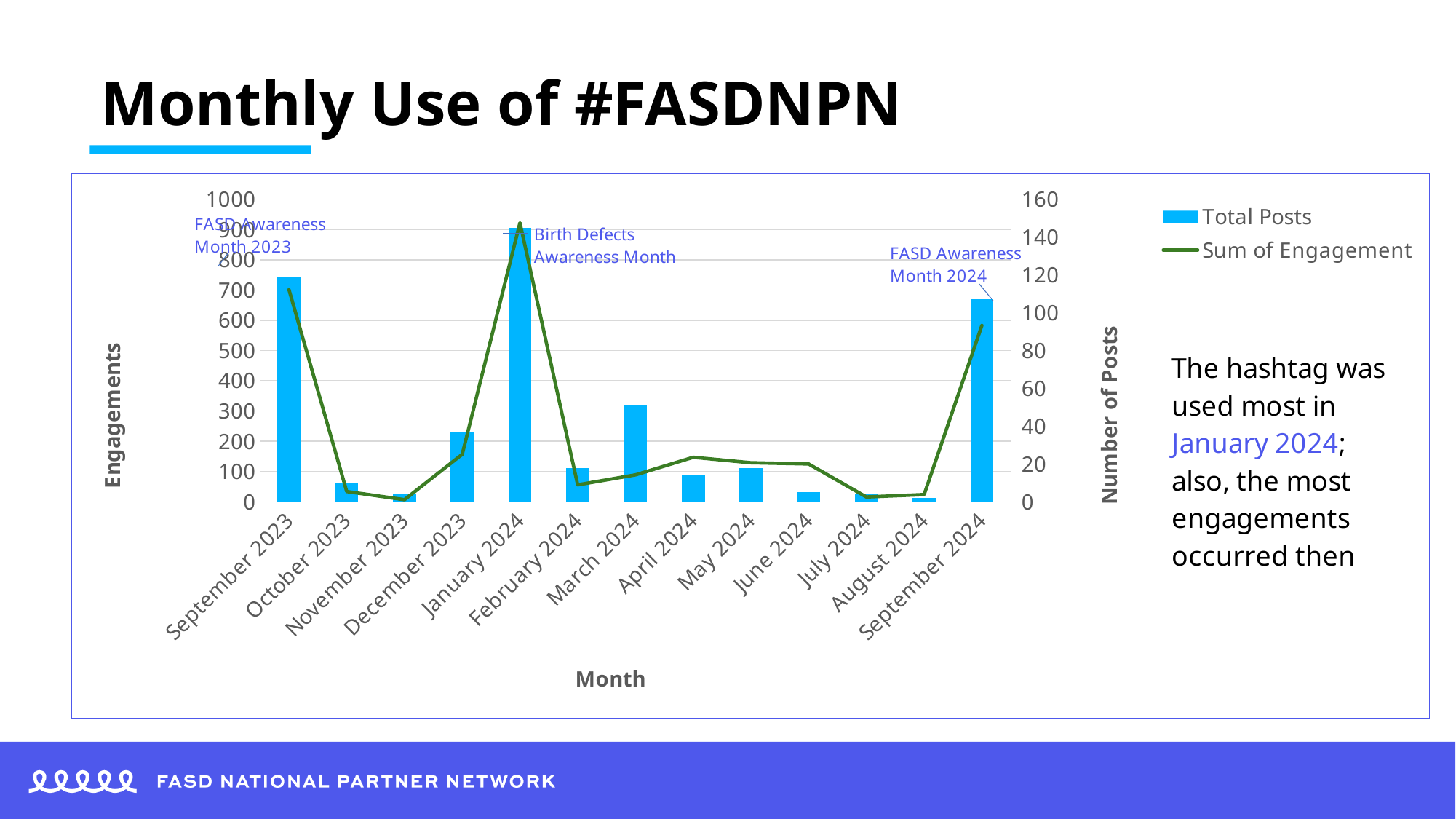
Does the Sum of Engagement generally rise or fall from January 2024 to August 2024? fall What is the title of the right-hand vertical axis? Number of Posts Is the Total Posts value for September 2023 greater or less than 100? greater How many months are plotted along the x axis? 13 Which month has more Total Posts, January 2024 or September 2023? January 2024 Is the Sum of Engagement for April 2024 greater or less than 200? less Which month has the highest number of Total Posts? January 2024 Which month has the highest Sum of Engagement? January 2024 How many series does the legend list? 2 What kind of chart is shown on the slide? A combined bar and line chart Is the Total Posts value for January 2024 greater or less than 120? greater